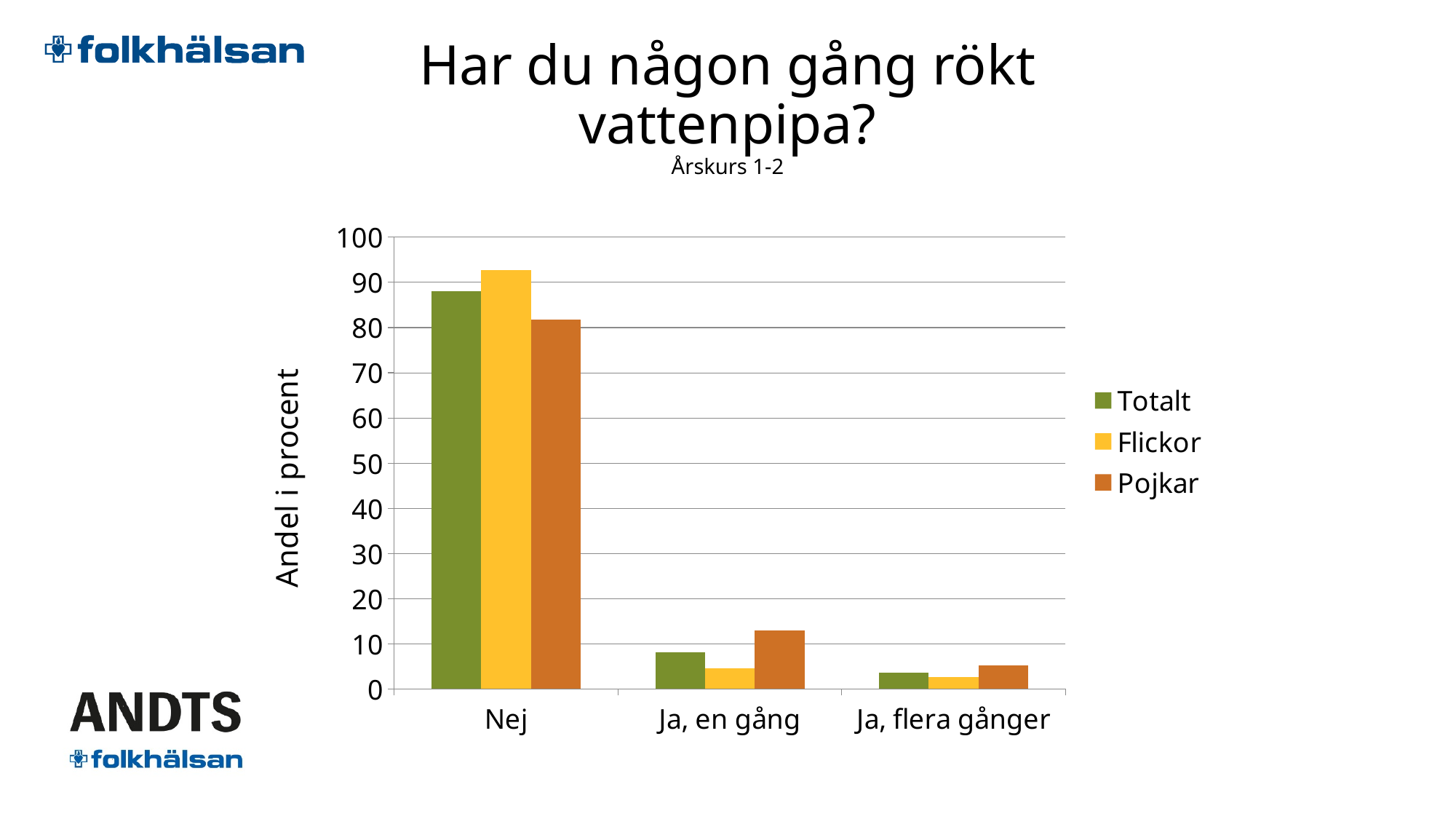
Do the Totalt values rise or fall from Nej to Ja, flera gånger along the x axis? fall In the Ja, en gång category, which is larger: Pojkar or Flickor? Pojkar What kind of chart is shown on the slide? bar chart Is the value for Pojkar in the Ja, en gång category greater or less than 10? greater For the Totalt series, which category has the highest value? Nej How many series does the legend list? 3 For the Pojkar series, which category has the lowest value? Ja, flera gånger What is the title of the y axis? Andel i procent How many answer categories are shown on the x axis? 3 Is the value for Pojkar in the Nej category greater or less than 90? less In the Nej category, which is larger: Flickor or Pojkar? Flickor Is the value for Flickor in the Nej category greater or less than 90? greater